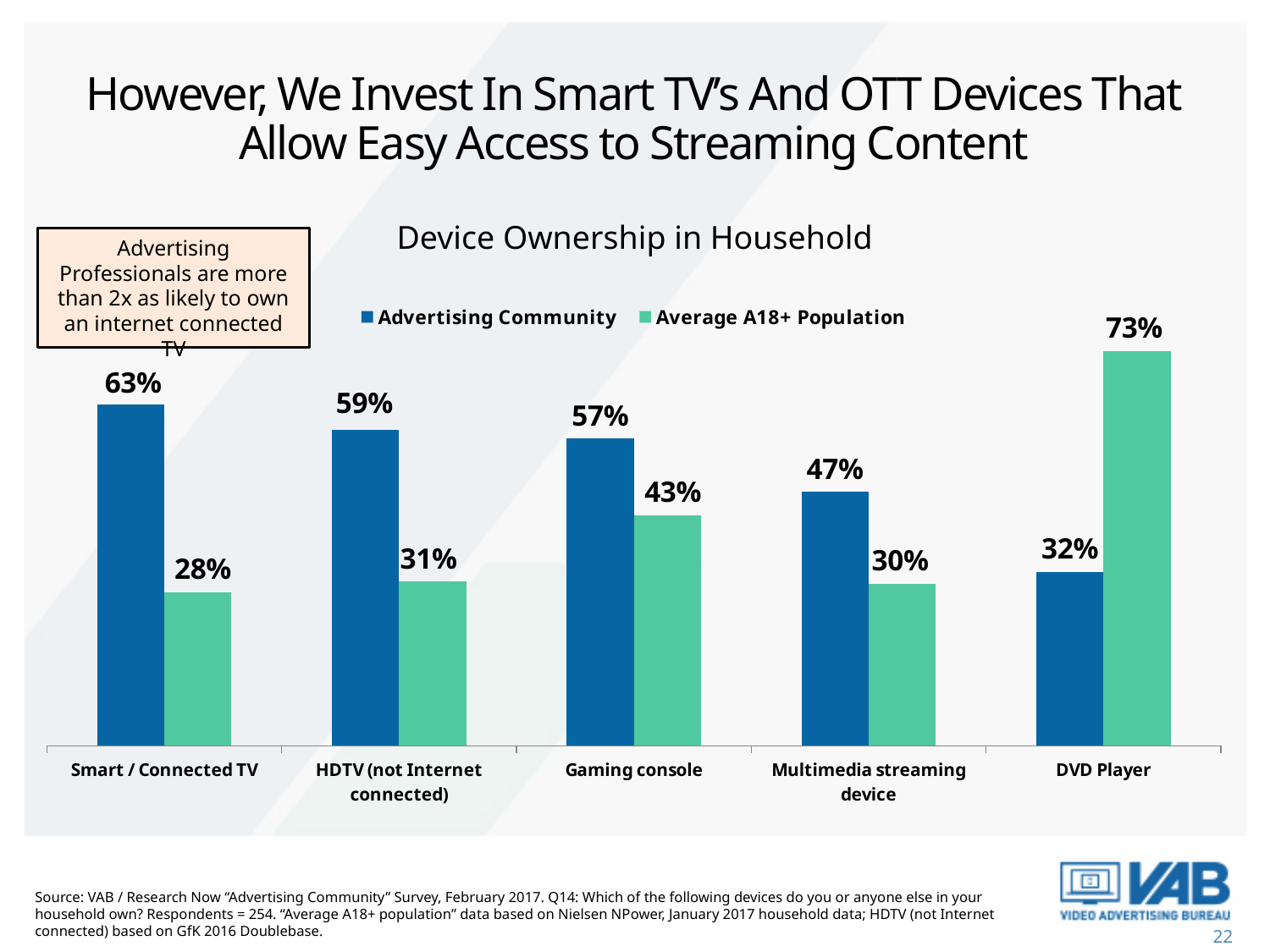
What is the Average A18+ Population value for Multimedia streaming device? 30% What percentage of the Advertising Community owns a Smart / Connected TV? 63% What type of chart is shown on the slide? Bar chart Which device has the highest Advertising Community ownership? Smart / Connected TV How many device categories are shown on the x axis? 5 What is the title of the chart? Device Ownership in Household What is the difference between the Advertising Community and Average A18+ Population values for Smart / Connected TV? 35% What is the difference between the Average A18+ Population and Advertising Community values for DVD Player? 41% Which device has the lowest Average A18+ Population ownership? Smart / Connected TV How many series does the legend list? 2 What is the Average A18+ Population value for DVD Player? 73% For Gaming console, which is larger: the Advertising Community value or the Average A18+ Population value? Advertising Community